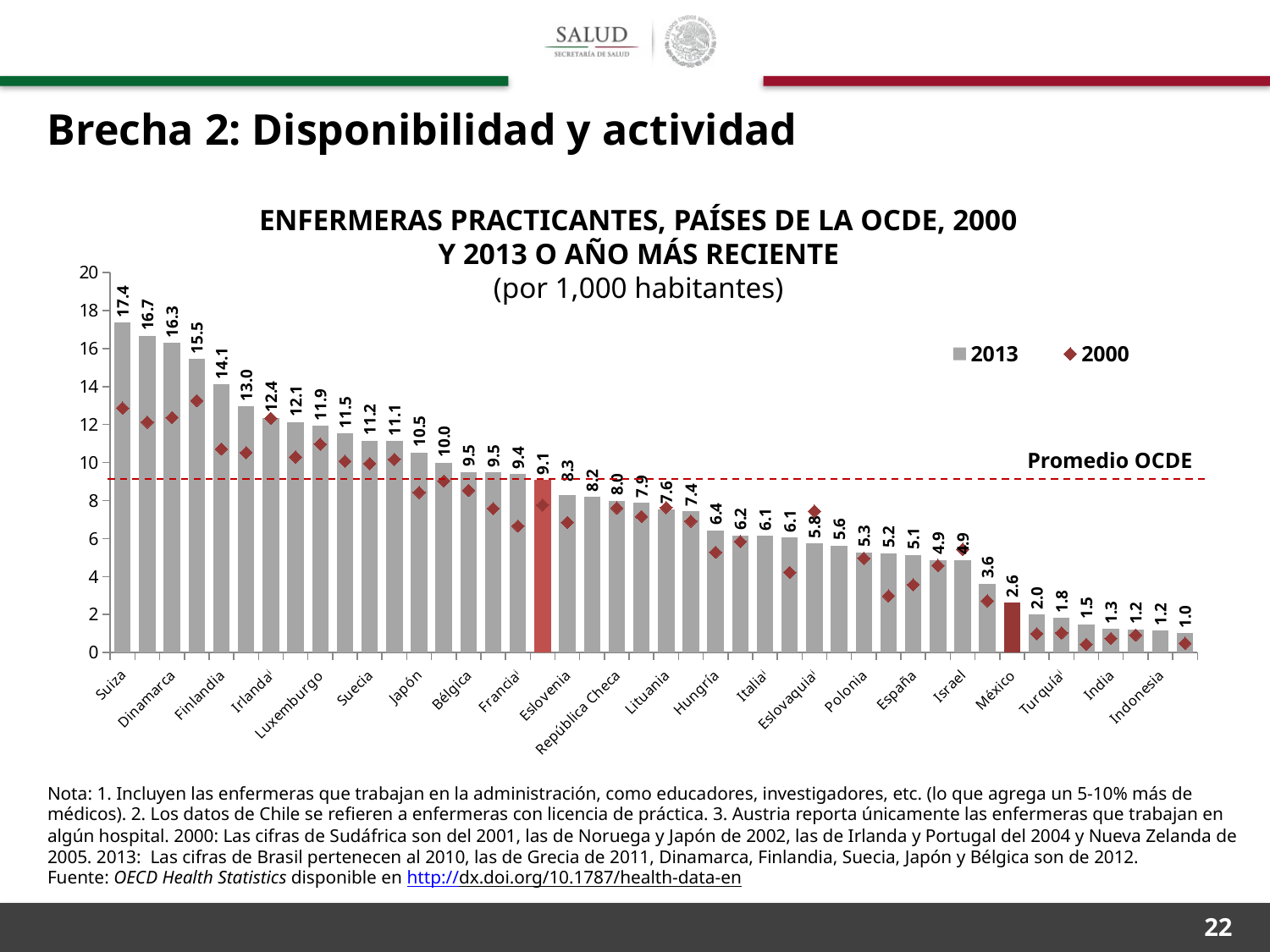
What is the 2013 value for México? 2.6 What is the lowest 2013 value shown on the chart? 1.0 What is the 2013 value for Suiza? 17.4 What is the value of the bar labelled as the Promedio OCDE (the highlighted bar at the dashed line)? 9.1 Do the 2013 values rise or fall from left to right along the x axis? Fall What is the difference between the 2013 values for Suiza and México? 14.8 Which has a larger 2013 value, Suiza or México? Suiza What kind of chart is this? Bar chart Which country has the highest 2013 value? Suiza Is the 2000 value for Suiza greater or less than 12? greater How many series does the legend list? 2